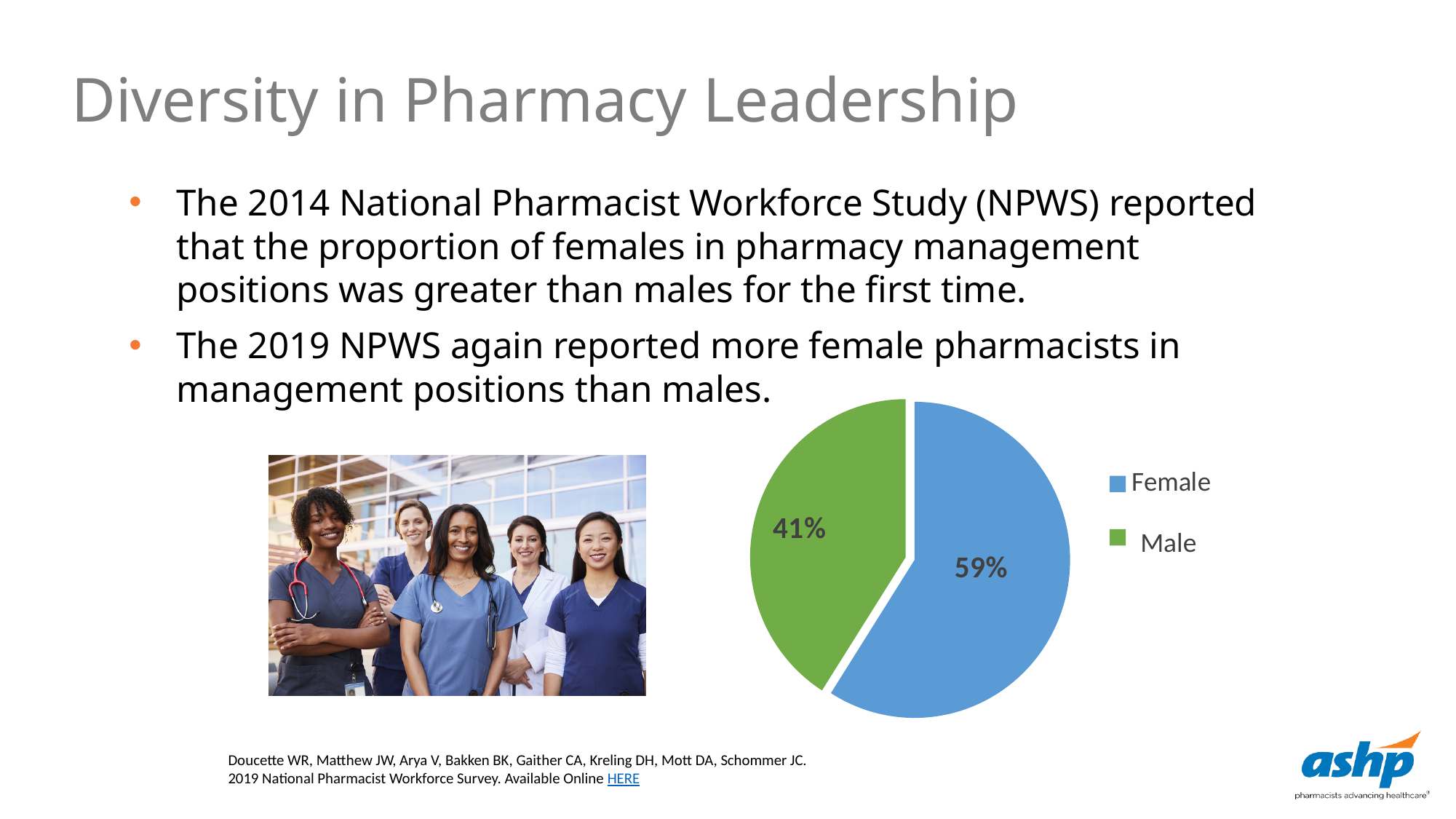
Is the Male share of the pie chart greater or less than 50%? less How many slices does the pie chart have? 2 Which slice is larger, Female or Male? Female What percentage of the pie chart is labelled Female? 59% Which category has the largest slice in the pie chart? Female What percentage of the pie chart is labelled Male? 41% What kind of chart is shown on the slide? Pie chart Which category has the smallest slice in the pie chart? Male What is the difference in percentage points between the Female and Male slices? 18 What colour is the Female slice in the pie chart? Blue How many entries does the legend of the pie chart list? 2 What colour is the Male slice in the pie chart? Green